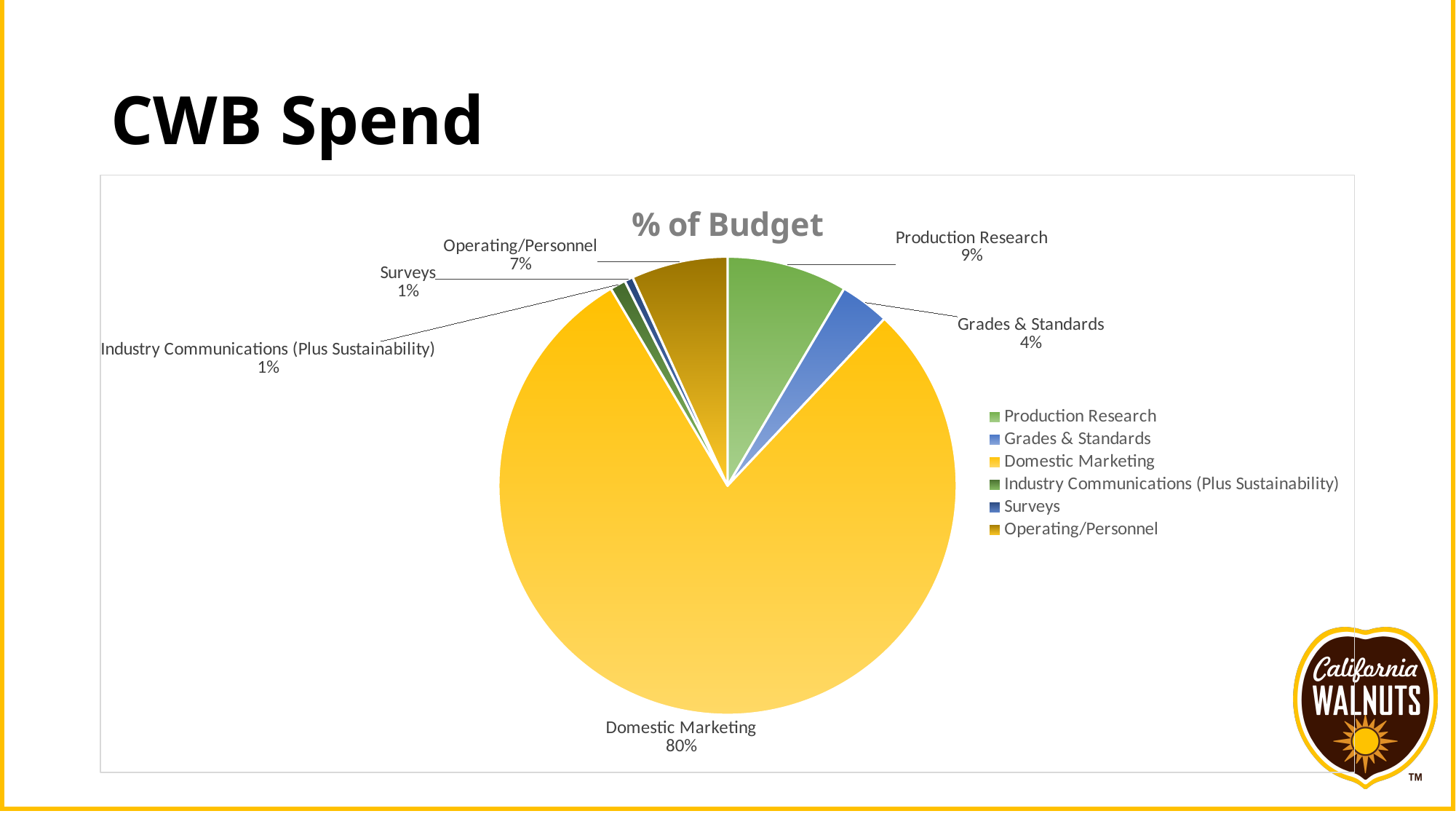
What is the combined share of Surveys and Industry Communications (Plus Sustainability)? 2% How many entries does the legend list? 6 Which has a larger share of the budget, Operating/Personnel or Grades & Standards? Operating/Personnel What percentage of the budget goes to Operating/Personnel? 7% What type of chart is shown on the slide? pie chart Which category has the largest share of the budget? Domestic Marketing What percentage of the budget goes to Production Research? 9% What is the title of the chart? % of Budget What is the difference in percentage points between Production Research and Grades & Standards? 5% What percentage of the budget goes to Grades & Standards? 4% How many categories are shown in the pie chart? 6 What percentage of the budget goes to Domestic Marketing? 80%